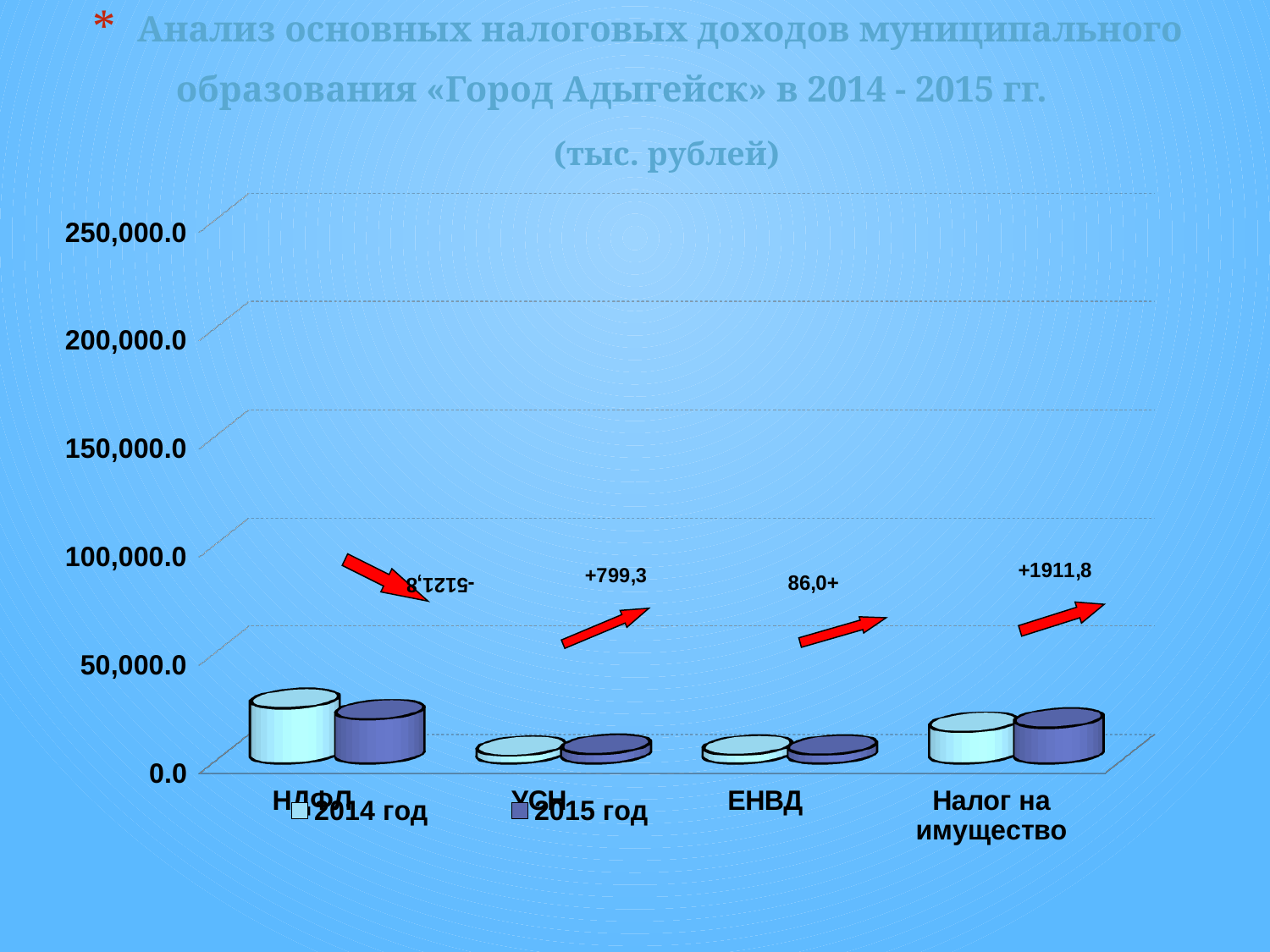
What change is annotated above the УСН bars? +799,3 Which category has the highest values in the chart? НДФЛ Is the value for НДФЛ in 2014 год greater or less than 50,000.0? less What are the two series named in the chart legend? 2014 год and 2015 год Which is larger: the 2015 год value for Налог на имущество or the 2015 год value for ЕНВД? Налог на имущество What change is annotated above the Налог на имущество bars? +1911,8 How many categories are shown on the x axis of the chart? 4 Which is larger: the 2014 год value for НДФЛ or the 2014 год value for УСН? НДФЛ Which is larger for НДФЛ: the 2014 год value or the 2015 год value? 2014 год How many series does the chart legend list? 2 What kind of chart is shown on the slide? bar chart Is the value for Налог на имущество in 2015 год greater or less than 100,000.0? less